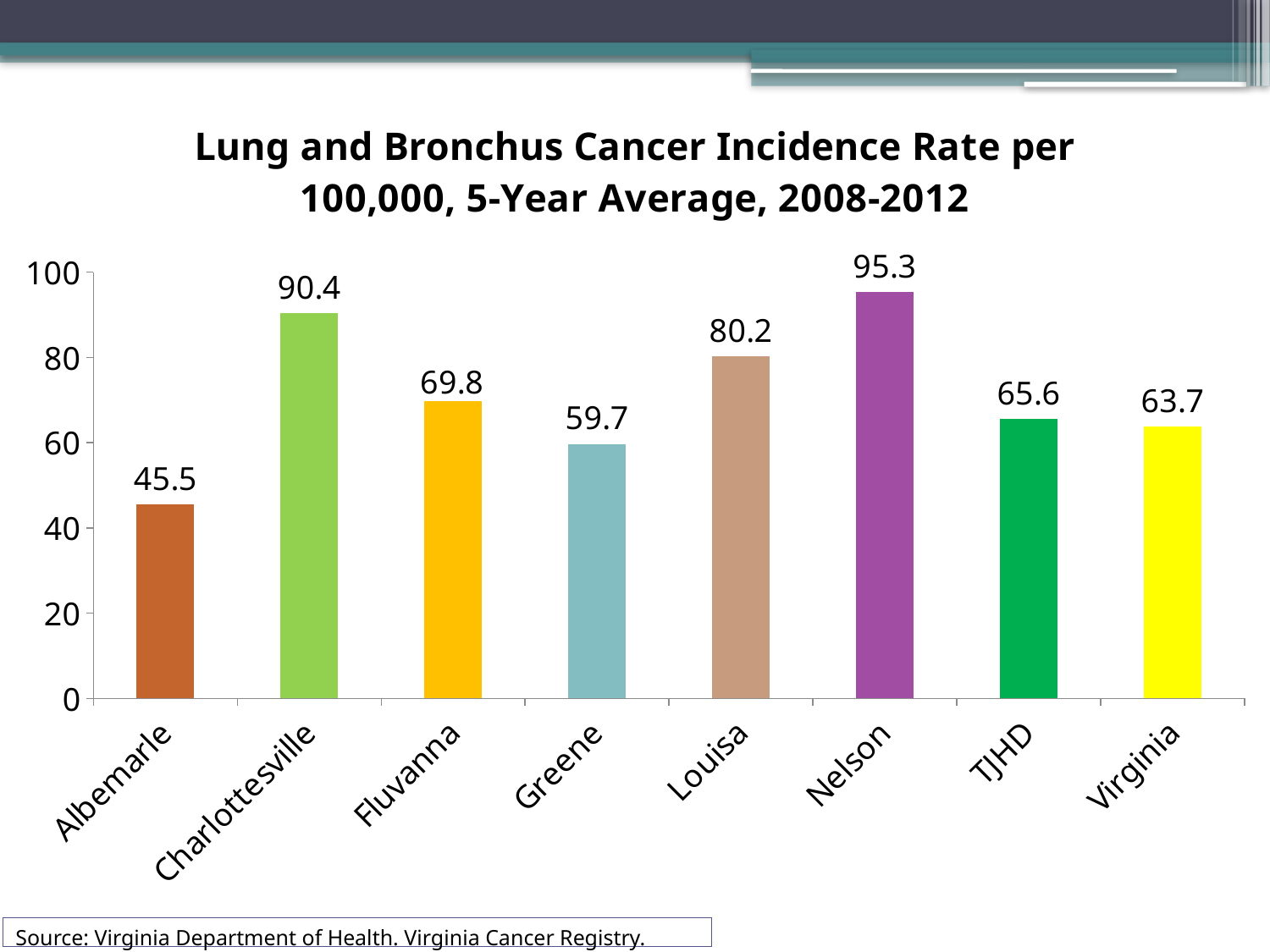
What is the lung and bronchus cancer incidence rate for Louisa? 80.2 Which category has the highest lung and bronchus cancer incidence rate? Nelson How many categories are shown on the x axis? 8 What is the difference between the incidence rates for Charlottesville and Albemarle? 44.9 Is the value for Nelson greater or less than 80? greater What kind of chart is shown on the slide? bar chart What is the lung and bronchus cancer incidence rate for Albemarle? 45.5 What is the title of the chart? Lung and Bronchus Cancer Incidence Rate per 100,000, 5-Year Average, 2008-2012 What is the lung and bronchus cancer incidence rate for Virginia? 63.7 Which has a higher incidence rate, Fluvanna or Greene? Fluvanna What is the difference between the incidence rates for TJHD and Virginia? 1.9 Which category has the lowest lung and bronchus cancer incidence rate? Albemarle